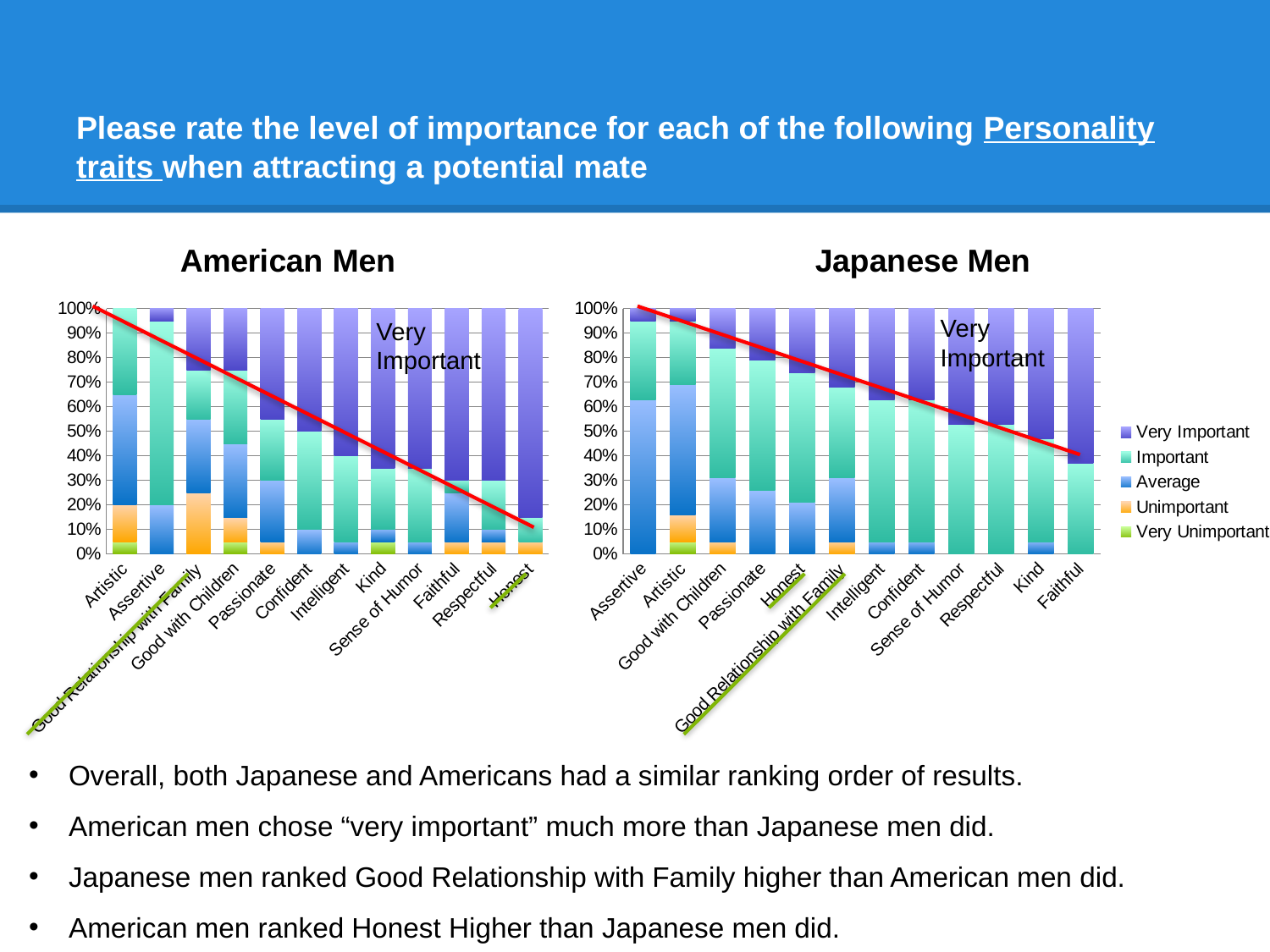
In the American Men chart, does the Very Important share rise or fall moving from left to right along the x axis? rise In the Japanese Men chart, which trait has the smallest Very Important share? Assertive and Artistic (tied) What are the five series listed in the legend? Very Important, Important, Average, Unimportant, Very Unimportant In the American Men chart, which is larger, the Very Important share for Honest or for Artistic? Honest How many personality traits are shown on the x axis of the Japanese Men chart? 12 How many series does the legend list? 5 What are the titles of the two charts on the slide? American Men and Japanese Men In the Japanese Men chart, which trait has the largest Very Important share? Faithful In the Japanese Men chart, is the Very Important share for Assertive greater or less than 20%? less What kind of chart is the American Men chart? Stacked bar chart In the American Men chart, is the Very Important share for Faithful greater or less than 50%? greater In the American Men chart, which trait has the largest Very Important share? Honest